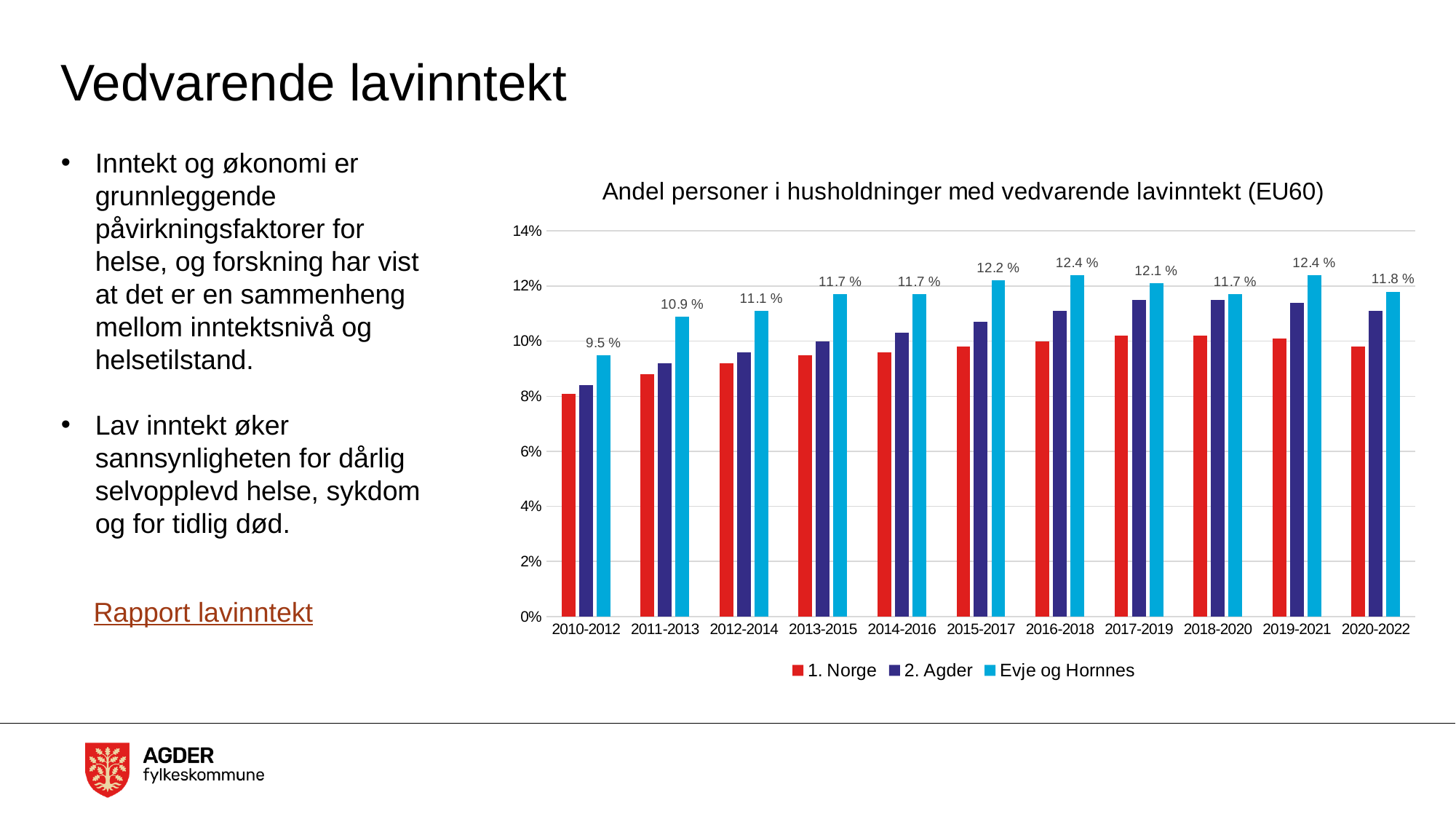
What kind of chart is shown on the slide? Bar chart What is the difference between the Evje og Hornnes values for 2020-2022 and 2010-2012? 2.3 percentage points How many periods are shown on the x axis? 11 What is the value for Evje og Hornnes in 2020-2022? 11.8 % How many series does the legend list? 3 Is the value for 1. Norge in 2011-2013 greater or less than 10%? less In which period is the value for Evje og Hornnes lowest? 2010-2012 Does the value for Evje og Hornnes rise or fall from 2010-2012 to 2015-2017? Rise What is the value for Evje og Hornnes in 2015-2017? 12.2 % Is the value for 2. Agder in 2020-2022 greater or less than 10%? greater In 2016-2018, which is larger: the value for 1. Norge or for Evje og Hornnes? Evje og Hornnes What is the value for Evje og Hornnes in 2010-2012? 9.5 %